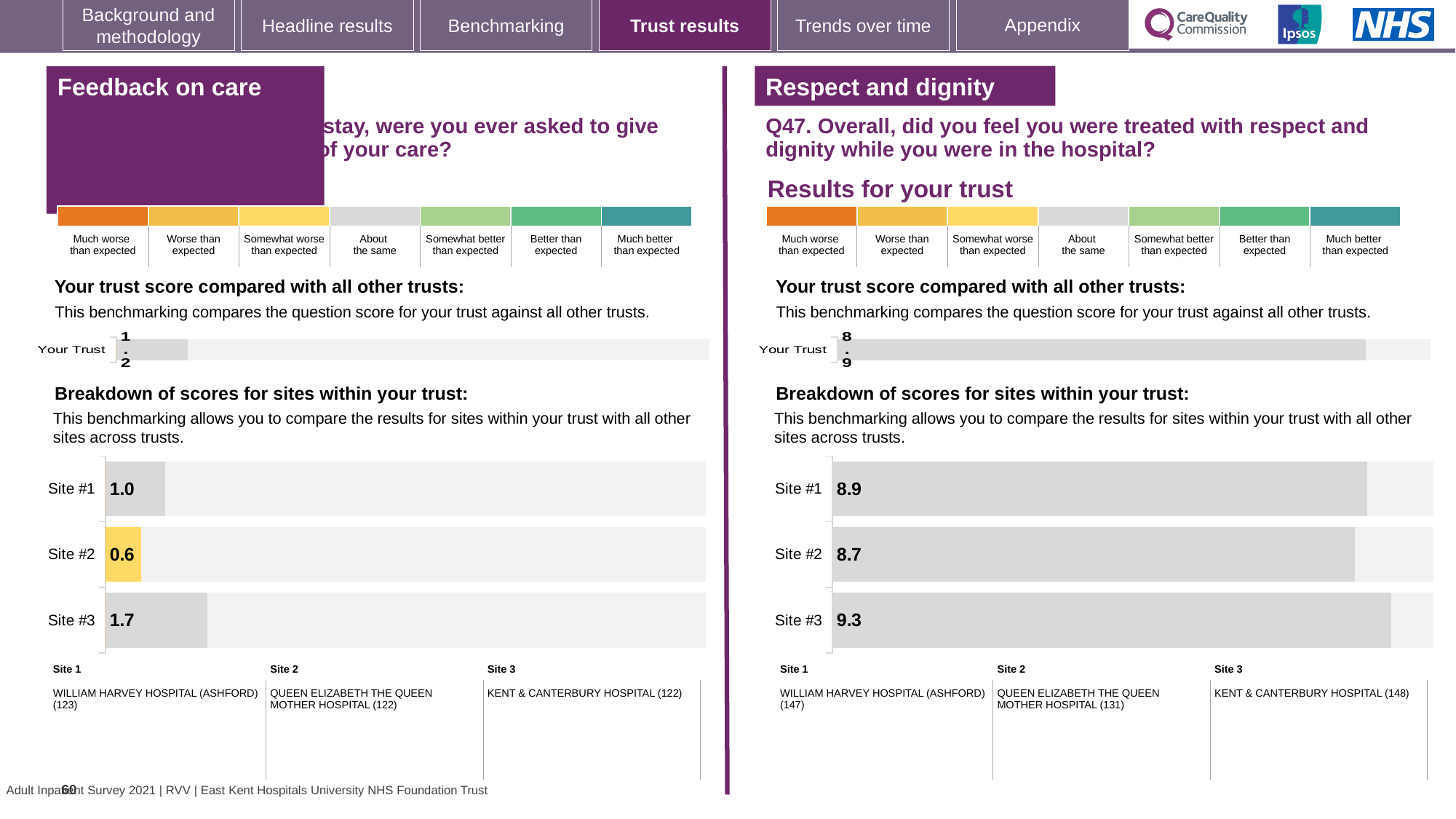
How many sites are shown in the 'Feedback on care' site breakdown chart? 3 In the 'Respect and dignity' site breakdown chart, which site has the lowest score? Site #2 In the 'Feedback on care' panel, what is the score shown for Your Trust in the 'Your trust score compared with all other trusts' chart? 1.2 In the 'Feedback on care' site breakdown chart, which site has the lowest score? Site #2 In the 'Respect and dignity' site breakdown chart, what is the score for Site #3? 9.3 In the 'Feedback on care' site breakdown chart, what is the difference between the scores for Site #3 and Site #2? 1.1 What type of chart is used for the site breakdown in the 'Respect and dignity' panel? Bar chart In the 'Respect and dignity' site breakdown chart, which has the larger score, Site #1 or Site #2? Site #1 In the 'Feedback on care' site breakdown chart, what is the score for Site #2? 0.6 In the 'Feedback on care' site breakdown chart, which site has the highest score? Site #3 In the 'Respect and dignity' site breakdown chart, what is the difference between the scores for Site #3 and Site #1? 0.4 In the 'Respect and dignity' panel, what is the score shown for Your Trust in the 'Your trust score compared with all other trusts' chart? 8.9